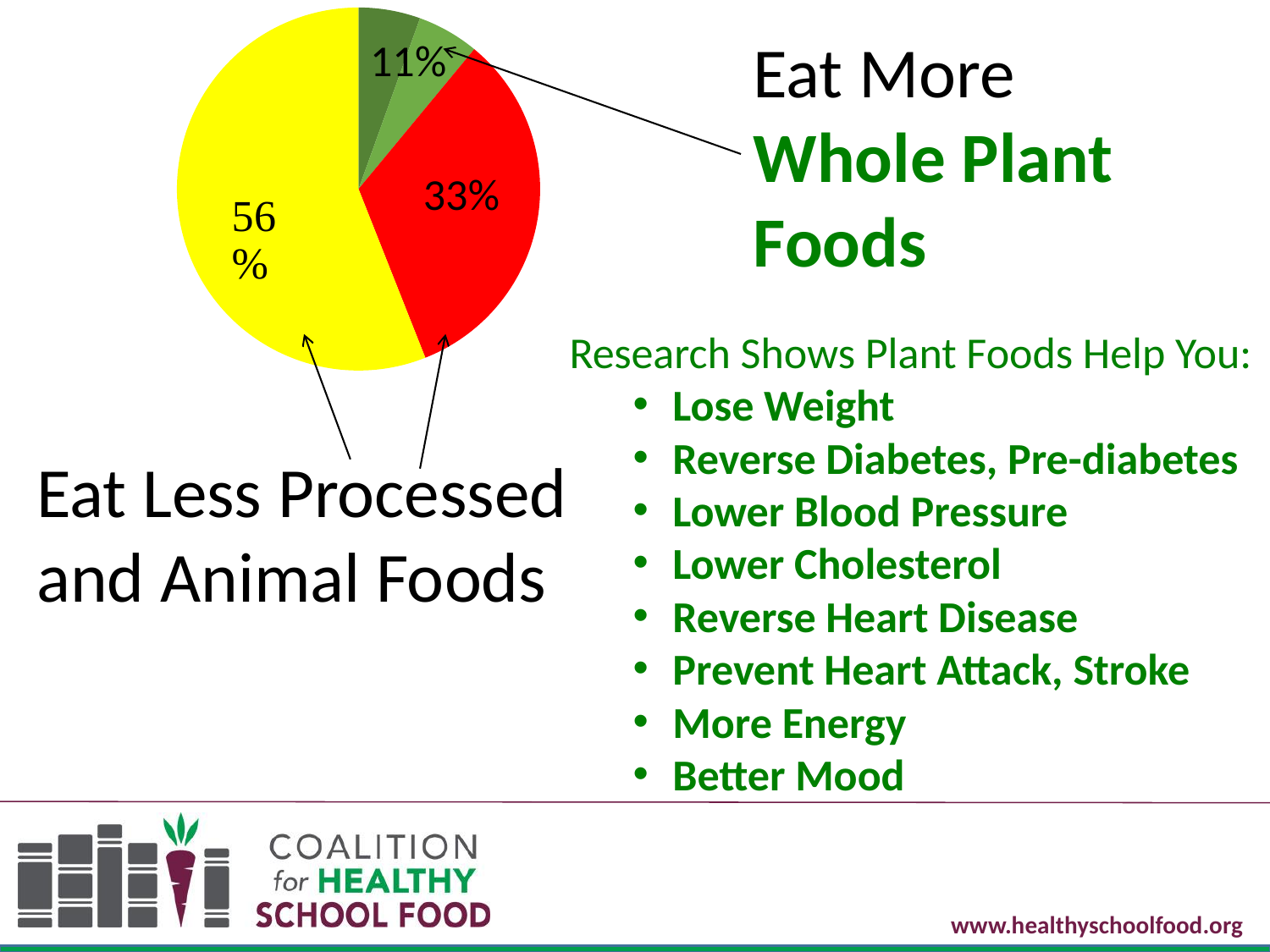
Which percentage of the pie chart is linked by an arrow to the text 'Eat More Whole Plant Foods'? 11% What is the smallest percentage labelled on the pie chart? 11% What percentage is printed on the green portion of the pie chart? 11% What kind of chart is shown on the slide? pie chart What percentage is printed on the yellow slice of the pie chart? 56% Which colour slice of the pie chart is the largest? yellow What percentage is printed on the red slice of the pie chart? 33% Which two slices of the pie chart are linked by arrows to the text 'Eat Less Processed and Animal Foods'? the yellow (56%) and red (33%) slices Which is larger, the red slice or the yellow slice of the pie chart? yellow What do the three percentage labels on the pie chart add up to? 100% What is the difference between the yellow slice's percentage and the red slice's percentage? 23% How many percentage labels are printed on the pie chart? 3